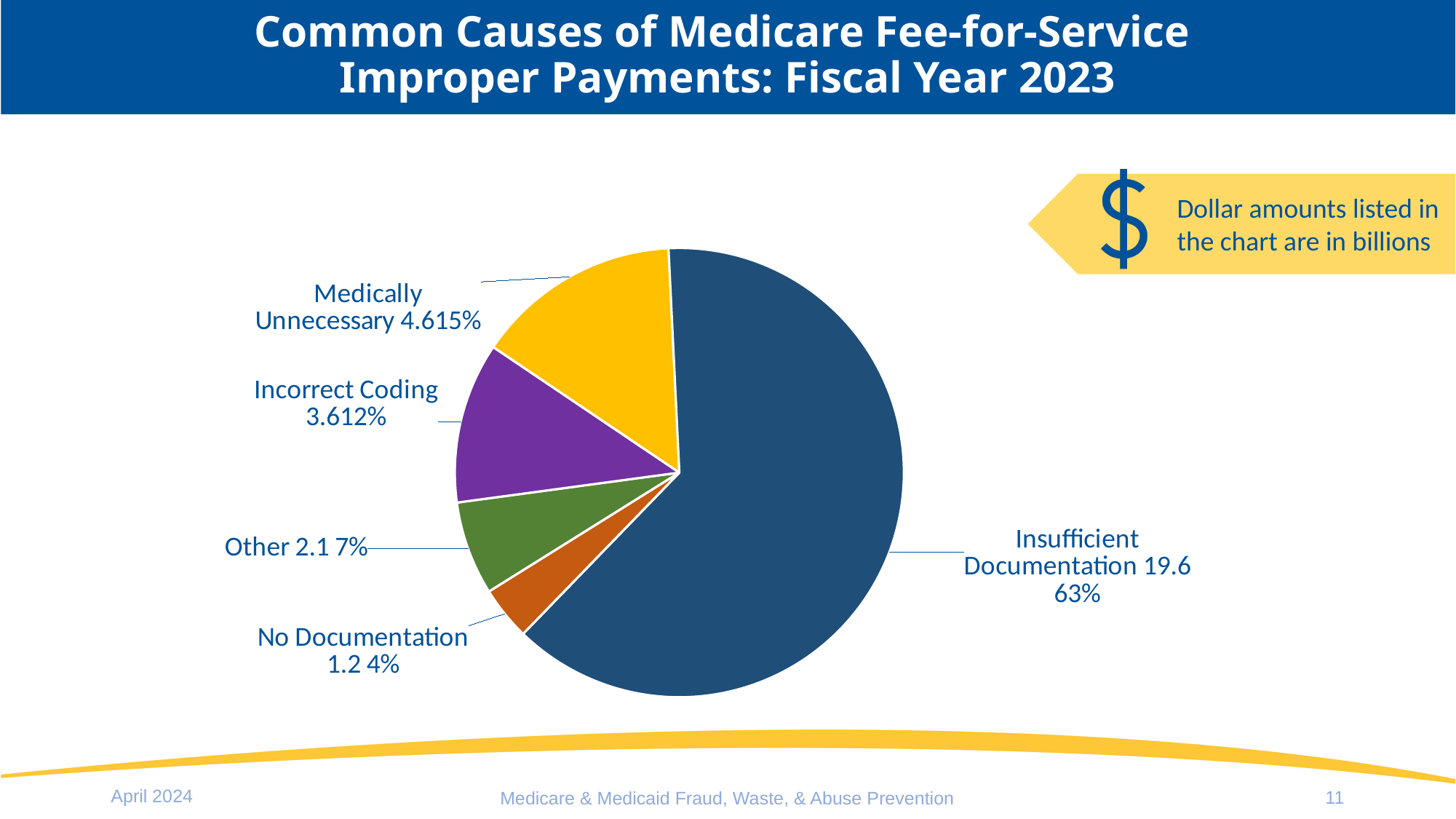
How many slices does the pie chart have? 5 What percentage share of the pie is Insufficient Documentation? 63% What is the difference in percentage share between Insufficient Documentation and Other? 56% What kind of chart is shown on the slide? pie chart Which cause accounts for the largest slice of the pie chart? Insufficient Documentation Which is larger, the slice for Other or the slice for No Documentation? Other What dollar amount (in billions) is shown for Other? 2.1 According to the callout on the slide, in what units are the dollar amounts in the chart? billions What percentage share of the pie is No Documentation? 4% What dollar amount (in billions) is shown for Insufficient Documentation? 19.6 Which cause accounts for the smallest slice of the pie chart? No Documentation Which is larger, the slice for Medically Unnecessary or the slice for Incorrect Coding? Medically Unnecessary